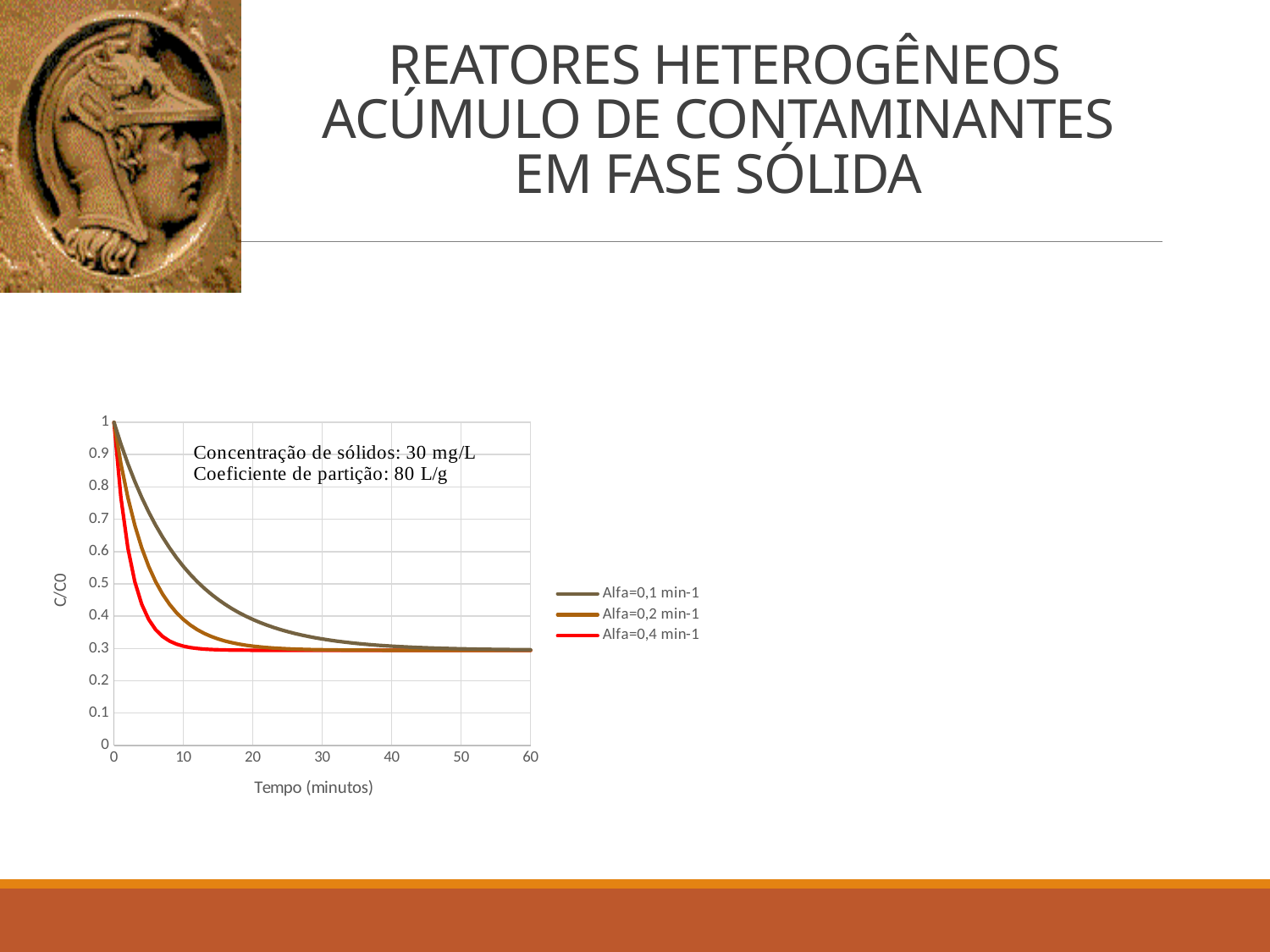
Which series has the lowest C/C0 value at Tempo = 5 minutos? Alfa=0,4 min-1 What kind of chart is shown on the slide? line chart At Tempo = 20 minutos, is the C/C0 value for Alfa=0,1 min-1 greater or less than 0.5? less Which series has the highest C/C0 value at Tempo = 10 minutos? Alfa=0,1 min-1 How many series does the legend list? 3 What is the C/C0 value of all three series at Tempo = 0 minutos? 1 Which series is drawn in red? Alfa=0,4 min-1 What is the label of the x axis? Tempo (minutos) At Tempo = 10 minutos, is the C/C0 value for Alfa=0,2 min-1 greater or less than 0.5? less Do the C/C0 values rise or fall as Tempo (minutos) increases? fall At Tempo = 10 minutos, is the C/C0 value for Alfa=0,4 min-1 greater or less than 0.4? less At Tempo = 5 minutos, which series has the higher C/C0 value, Alfa=0,1 min-1 or Alfa=0,4 min-1? Alfa=0,1 min-1